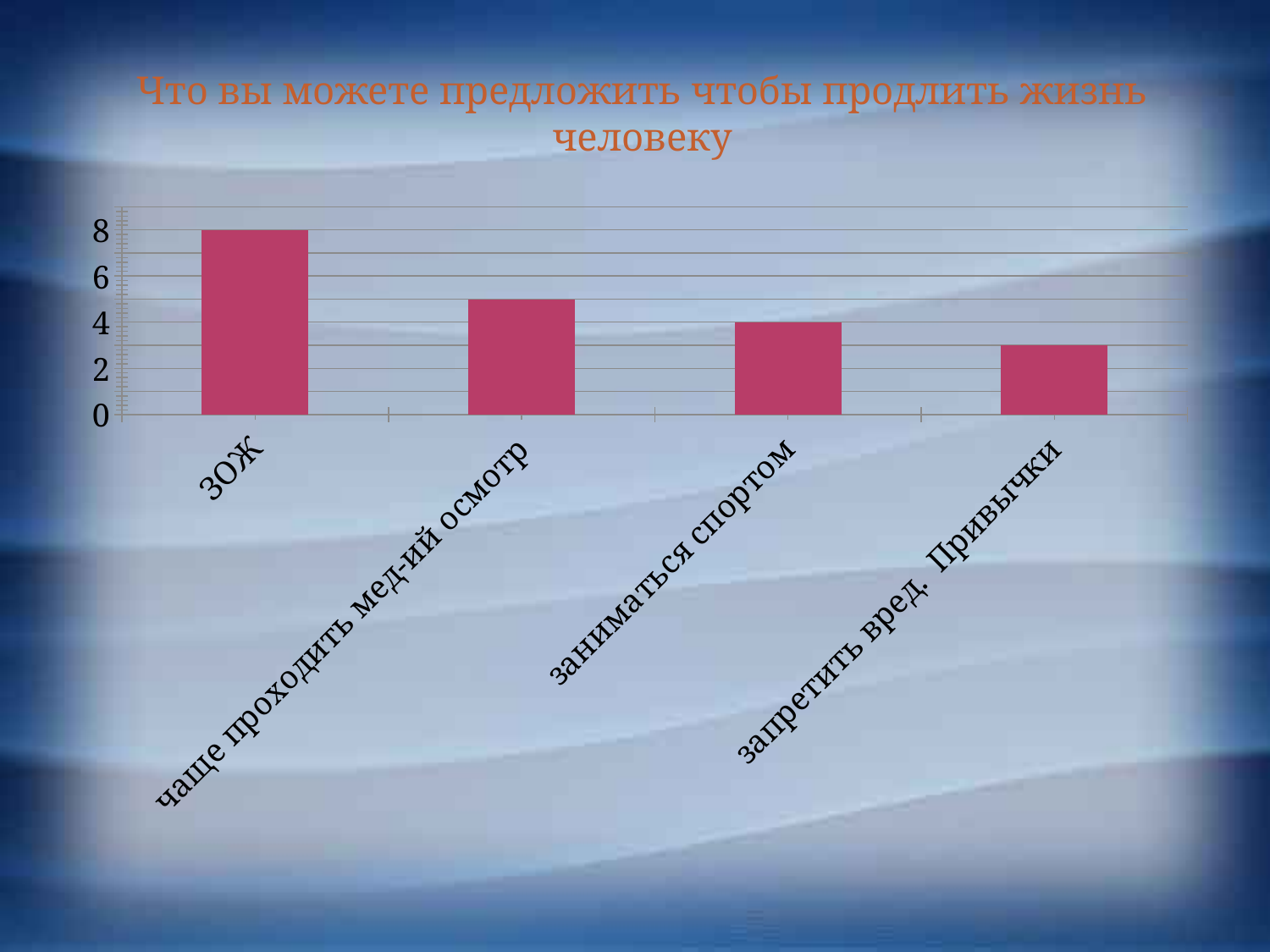
Is the value for запретить вред. Привычки greater or less than 4? less What is the value for ЗОЖ? 8 What is the title of the chart on the slide? Что вы можете предложить чтобы продлить жизнь человеку Which category has the highest bar? ЗОЖ Which category has the lowest bar? запретить вред. Привычки What kind of chart is shown on the slide? bar chart Is the value for чаще проходить мед-ий осмотр greater or less than 4? greater What is the value for заниматься спортом? 4 How many categories are shown on the x axis of the chart? 4 Which is larger, the value for ЗОЖ or the value for заниматься спортом? ЗОЖ Do the bar values rise or fall from left to right along the x axis? fall What is the difference between the values for ЗОЖ and заниматься спортом? 4